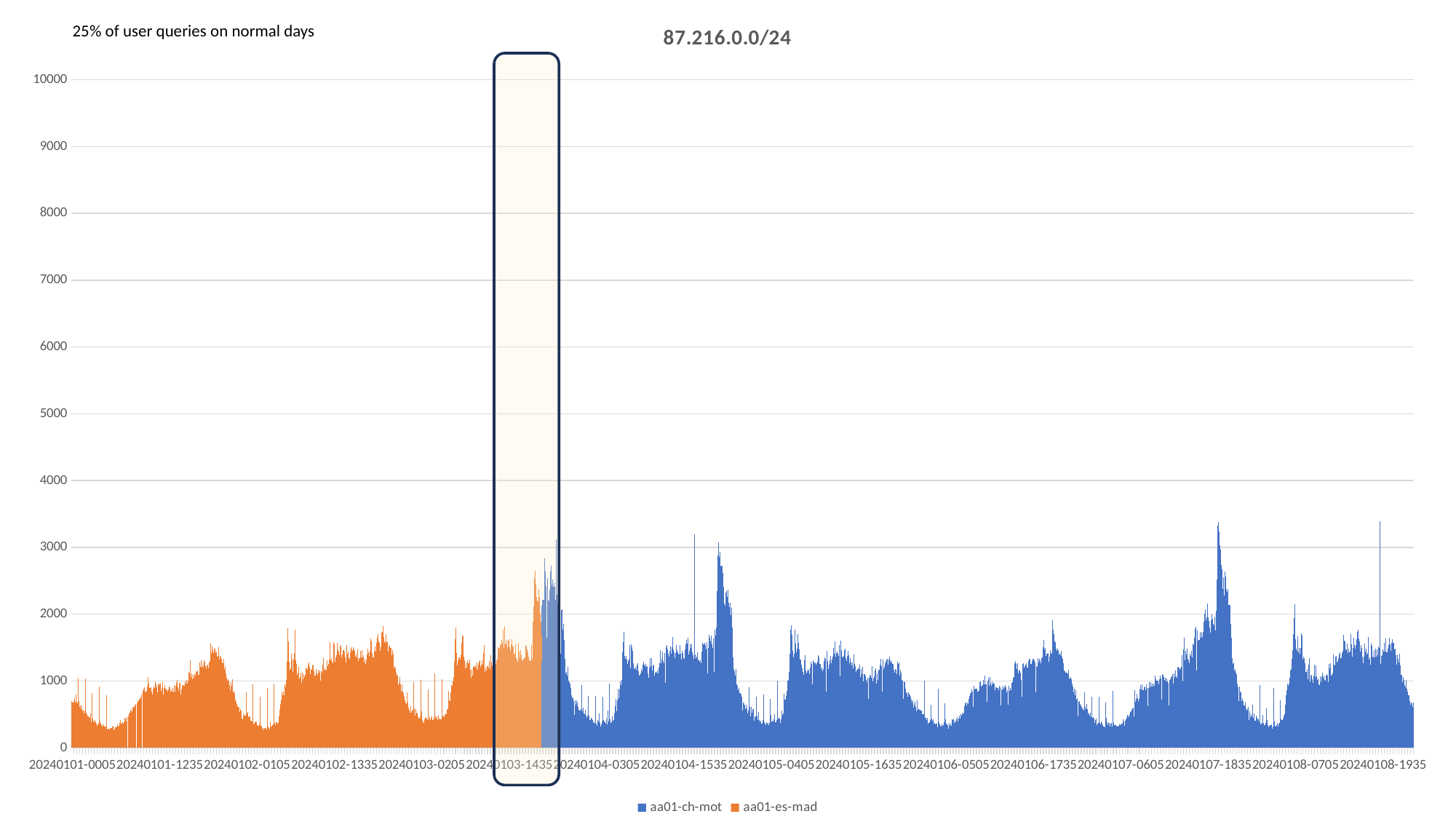
Which series reaches a higher peak value, aa01-ch-mot or aa01-es-mad? aa01-ch-mot Is the highest value reached by aa01-es-mad greater or less than 2000? greater How many series does the legend list? 2 Is the highest value reached by aa01-ch-mot greater or less than 4000? less Does any value on the chart exceed 5000? No What kind of chart is shown on the slide? bar chart Which series occupies the earlier (left) part of the time axis? aa01-es-mad Which series is drawn in orange? aa01-es-mad What is the title of the chart? 87.216.0.0/24